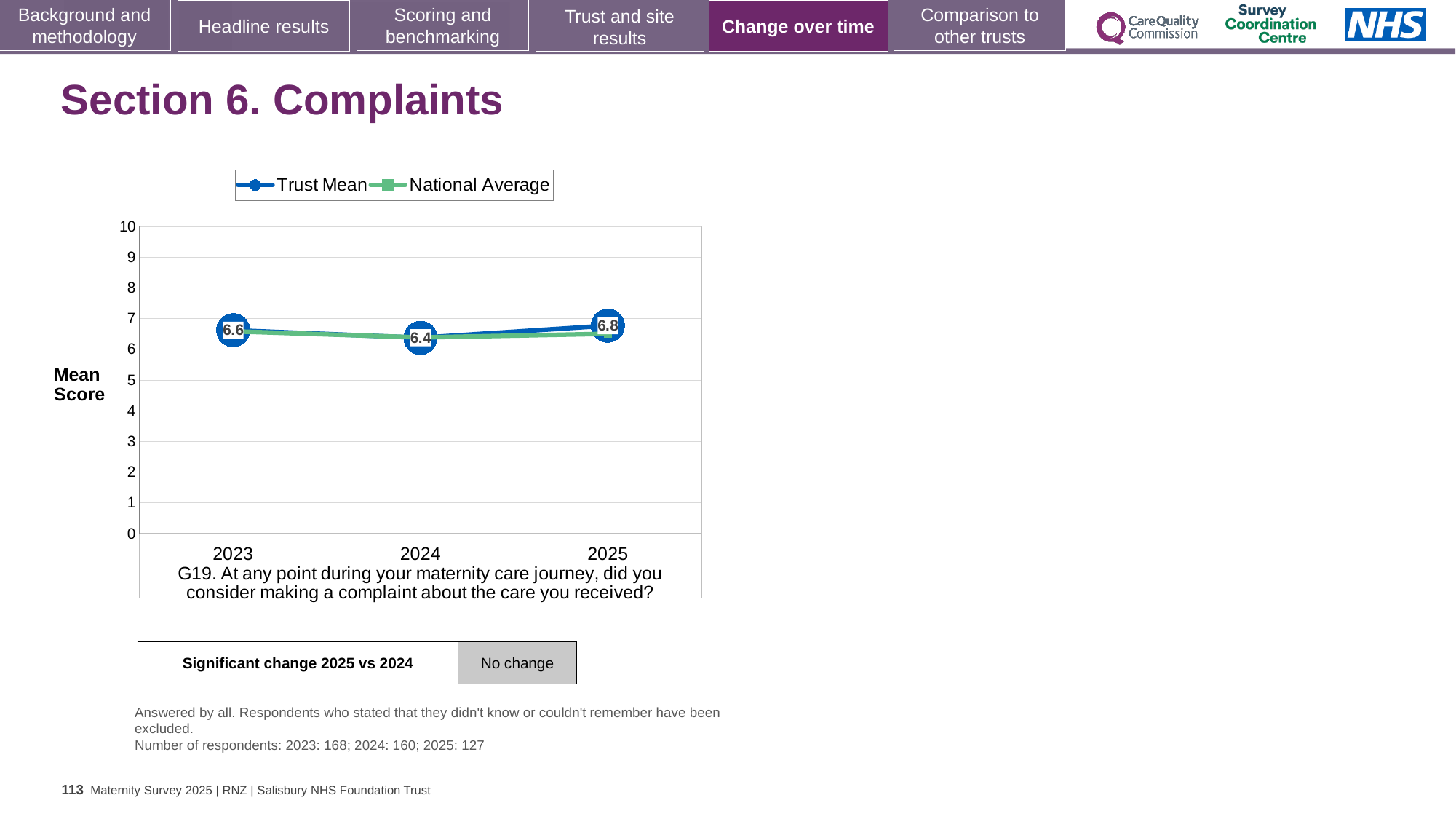
What is the Trust Mean score for 2024? 6.4 Is the National Average value for 2025 greater or less than 5? greater How many years are plotted on the x axis? 3 In which year is the Trust Mean score lowest? 2024 Which year has the larger Trust Mean score, 2023 or 2025? 2025 What kind of chart is shown on the slide? line chart What is the Trust Mean score for 2023? 6.6 In which year is the Trust Mean score highest? 2025 Between 2024 and 2025, does the Trust Mean score rise or fall? rise What is the Trust Mean score for 2025? 6.8 What is the difference between the Trust Mean scores for 2025 and 2024? 0.4 How many series does the legend list? 2